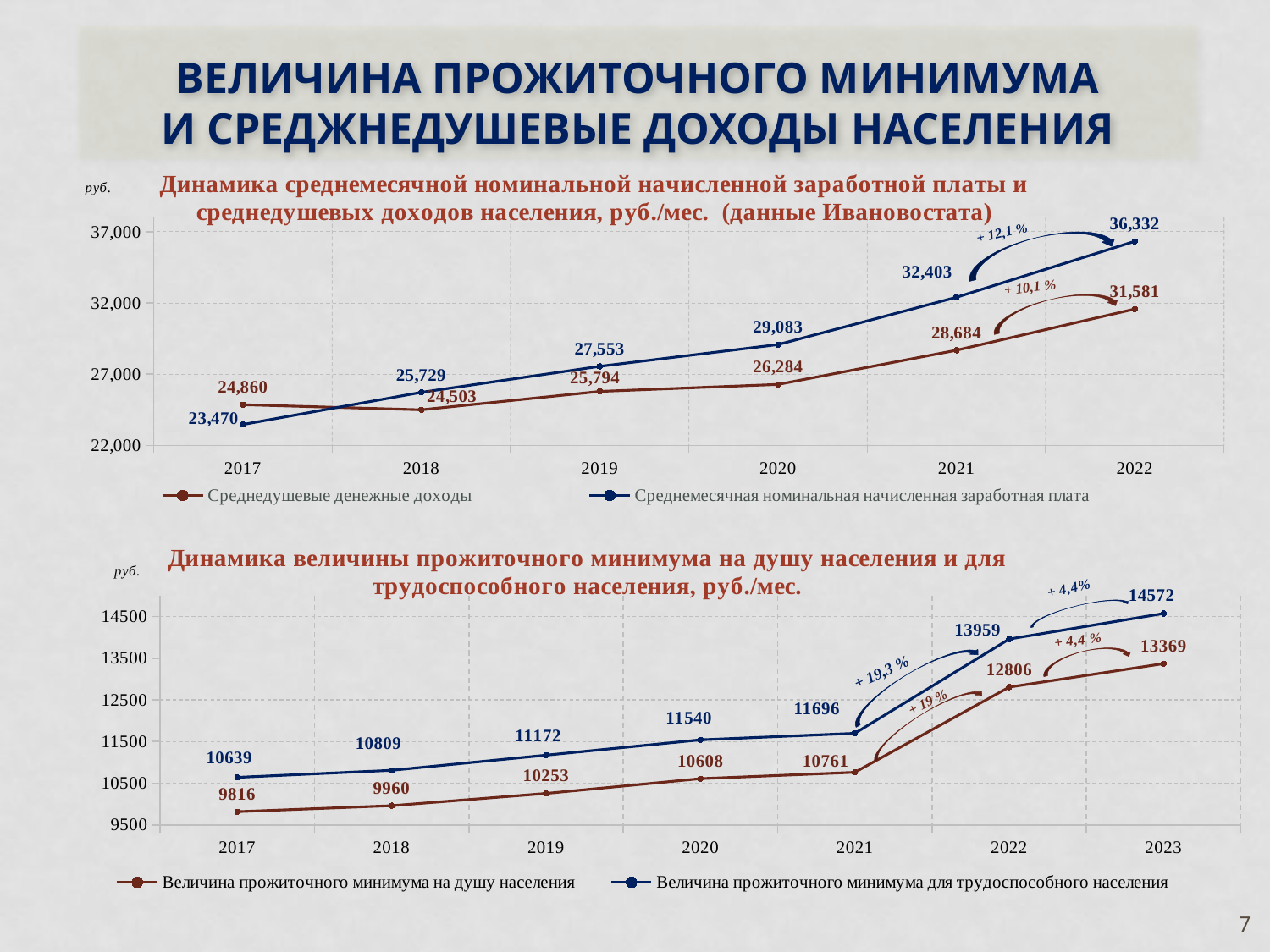
In the top chart, what is the value of Среднедушевые денежные доходы in 2017? 24,860 In the top chart, what is the difference between Среднемесячная номинальная начисленная заработная плата and Среднедушевые денежные доходы in 2021? 3,719 What type of chart is the bottom chart? Line chart In the top chart, how many series does the legend list? 2 In the top chart, what is the value of Среднемесячная номинальная начисленная заработная плата in 2022? 36,332 In the bottom chart, does Величина прожиточного минимума на душу населения rise or fall from 2017 to 2023? Rise In the top chart, in which year is Среднедушевые денежные доходы lowest? 2018 In the bottom chart, what is the value of Величина прожиточного минимума для трудоспособного населения in 2019? 11172 In the top chart, which series has the higher value in 2017? Среднедушевые денежные доходы In the bottom chart, what is the difference between the 2022 and 2021 values of Величина прожиточного минимума для трудоспособного населения? 2263 In the bottom chart, what is the value of Величина прожиточного минимума на душу населения in 2023? 13369 In the bottom chart, how many years are plotted on the x axis? 7